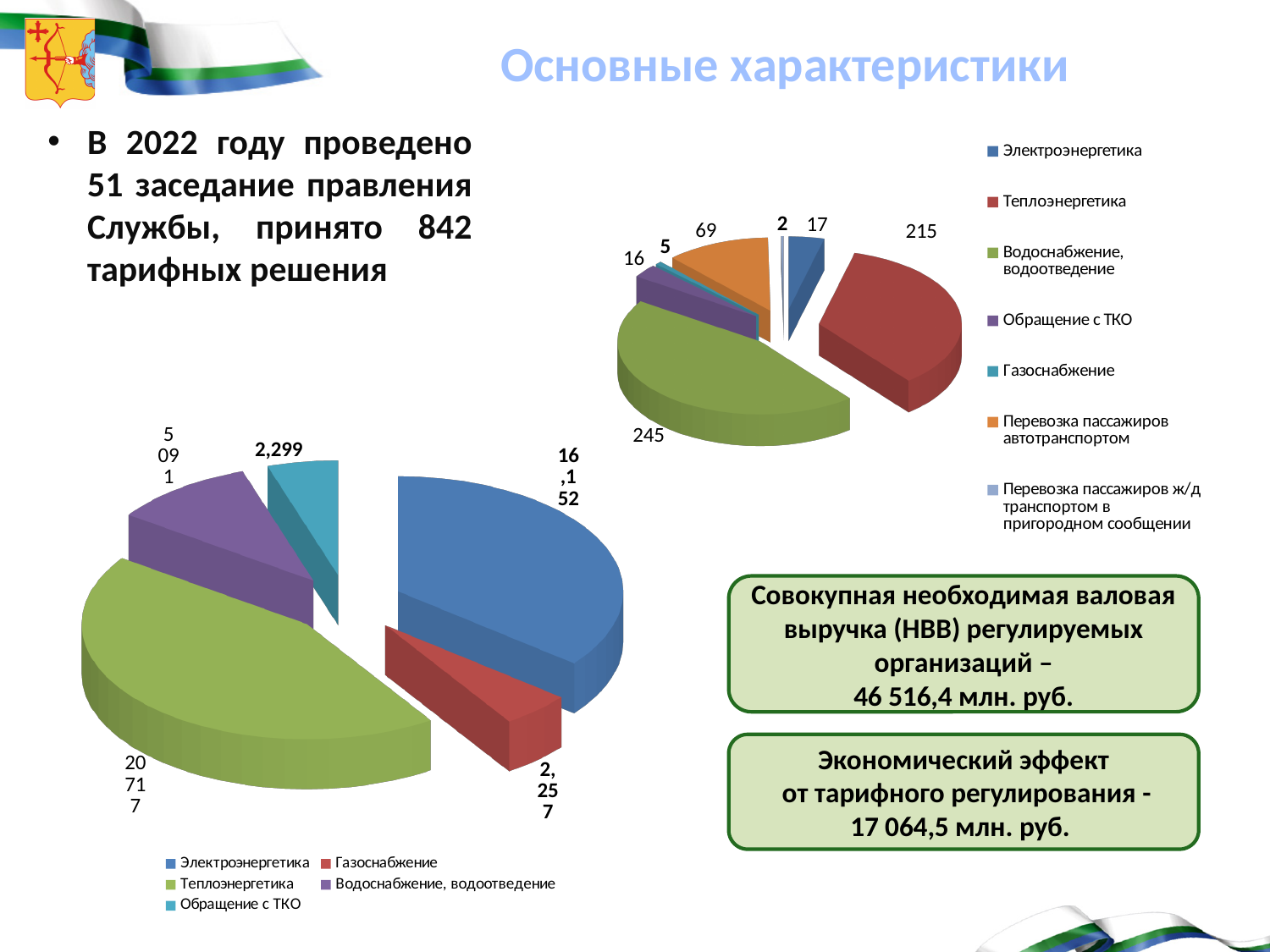
In the top-right pie chart, which category has the smallest value? Перевозка пассажиров ж/д транспортом в пригородном сообщении In the bottom-left pie chart, what is the value for Электроэнергетика? 16,152 In the top-right pie chart, what is the difference between the values for Водоснабжение, водоотведение and Теплоэнергетика? 30 In the top-right pie chart, which category has the largest value? Водоснабжение, водоотведение How many categories does the legend of the bottom-left pie chart list? 5 In the top-right pie chart, what is the value for Перевозка пассажиров автотранспортом? 69 In the top-right pie chart, what is the value for Теплоэнергетика? 215 How many categories does the legend of the top-right pie chart list? 7 In the bottom-left pie chart, which is larger: Газоснабжение or Водоснабжение, водоотведение? Водоснабжение, водоотведение What type of chart is the bottom-left chart? Pie chart In the top-right pie chart, what is the value for Водоснабжение, водоотведение? 245 In the bottom-left pie chart, what is the value for Теплоэнергетика? 20,717